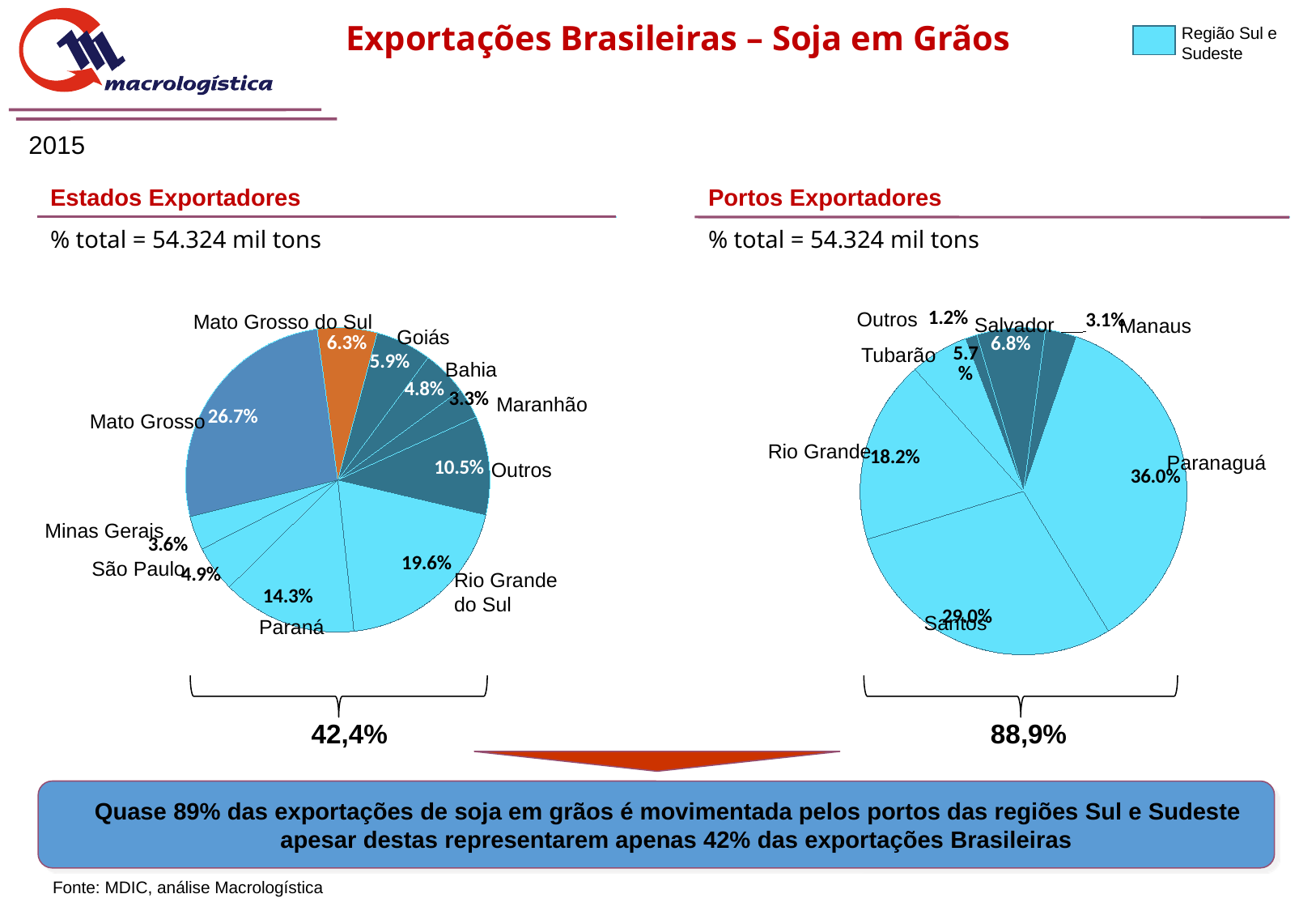
In the Estados Exportadores chart, what share does Mato Grosso have? 26.7% In the Estados Exportadores chart, what is the difference between the shares of Paraná and São Paulo? 9.4% In the Portos Exportadores chart, what share does Santos have? 29.0% In the Estados Exportadores chart, which state has the largest share? Mato Grosso In the Portos Exportadores chart, which is larger, Rio Grande or Salvador? Rio Grande In the Portos Exportadores chart, which category has the smallest share? Outros In the Estados Exportadores chart, which category has the smallest share? Maranhão In the Portos Exportadores chart, which port has the largest share? Paranaguá In the Estados Exportadores chart, what share does Rio Grande do Sul have? 19.6% In the Portos Exportadores chart, what is the difference between the shares of Paranaguá and Santos? 7.0% What type of chart is used for Portos Exportadores? Pie chart In the Estados Exportadores chart, how many slices does the pie have? 10